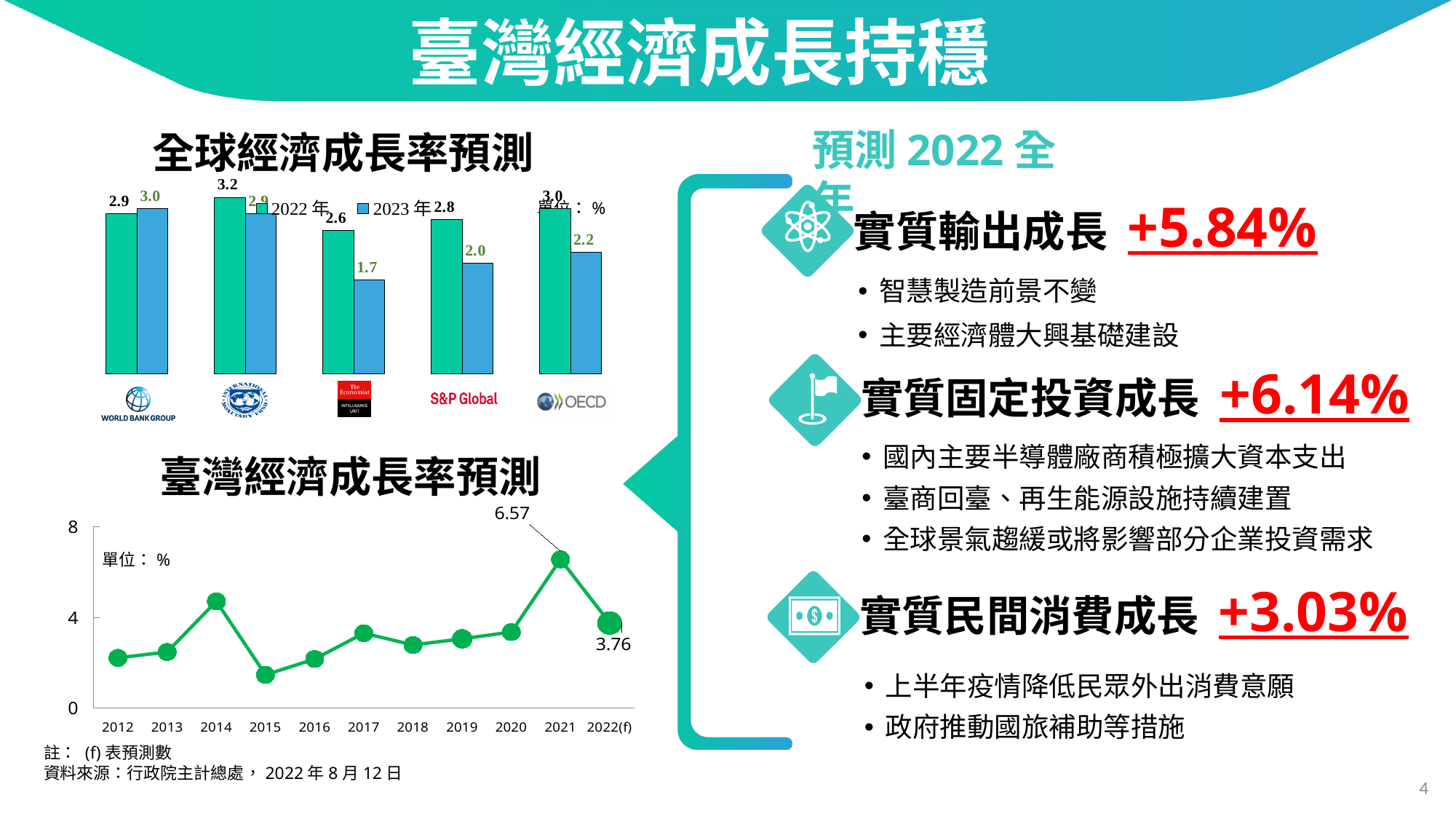
What kind of chart is the top chart titled 全球經濟成長率預測? bar chart In the 全球經濟成長率預測 chart, what is the 2022年 forecast from the World Bank Group? 2.9 In the 全球經濟成長率預測 chart, which institution has the lowest 2023年 forecast? The Economist Intelligence Unit In the 全球經濟成長率預測 chart, how many series does the legend list? 2 In the 全球經濟成長率預測 chart, what is the difference between the S&P Global 2022年 and 2023年 forecasts? 0.8 In the 臺灣經濟成長率預測 chart, how many years are plotted on the x axis? 11 In the 臺灣經濟成長率預測 chart, is the value for 2015 greater or less than 4? less In the 臺灣經濟成長率預測 chart, what is the value for 2022(f)? 3.76 What kind of chart is the bottom chart titled 臺灣經濟成長率預測? line chart In the 全球經濟成長率預測 chart, what is the 2023年 forecast from the Economist Intelligence Unit? 1.7 In the 臺灣經濟成長率預測 chart, what is the value for 2021? 6.57 In the 全球經濟成長率預測 chart, which institution has the highest 2022年 forecast? IMF